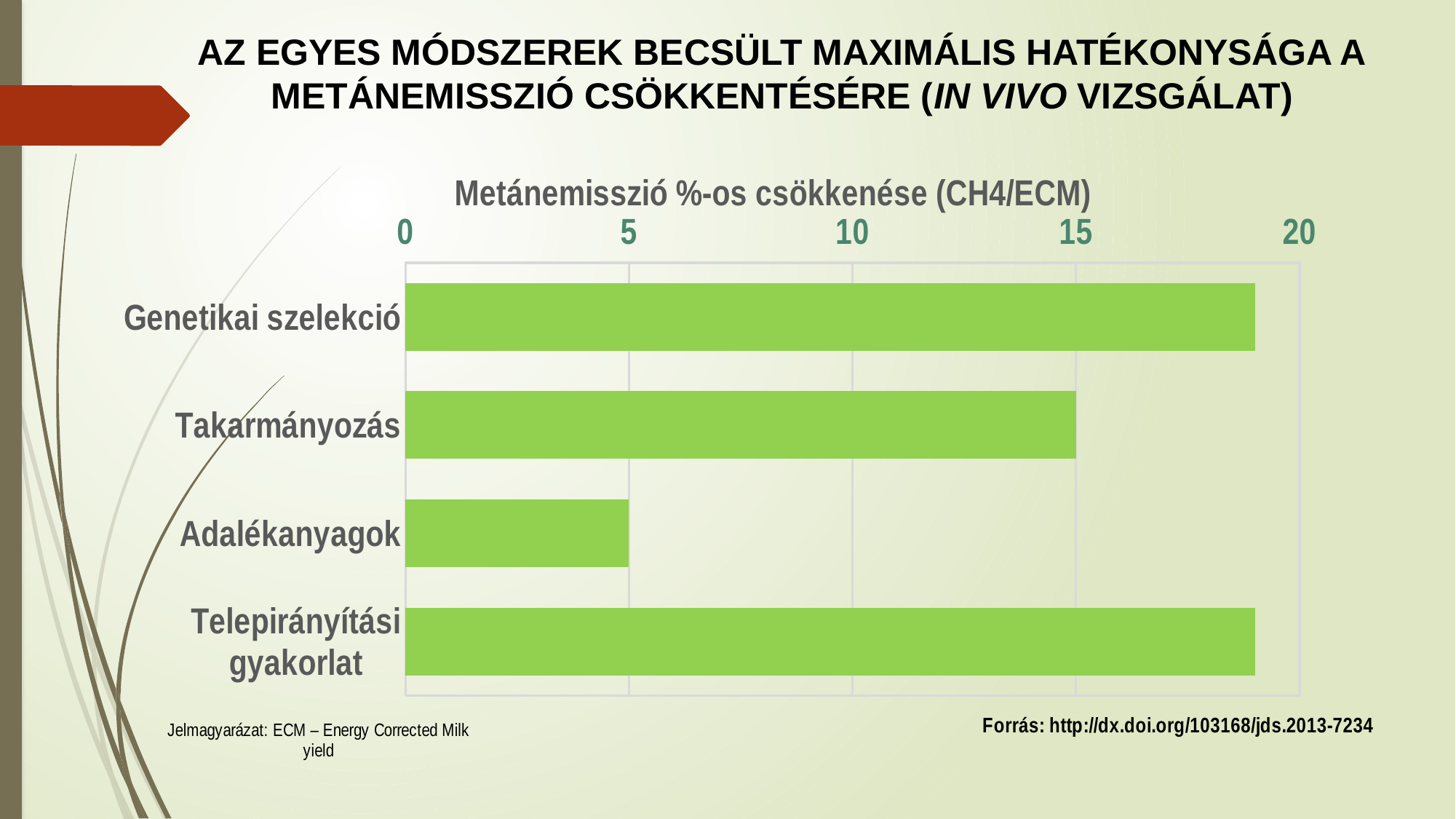
How many categories are plotted in the chart? 4 What is the title of the chart? Metánemisszió %-os csökkenése (CH4/ECM) What kind of chart is shown on the slide? bar chart Which is larger, the value for Adalékanyagok or the value for Telepirányítási gyakorlat? Telepirányítási gyakorlat Which category has the lowest value? Adalékanyagok Which is larger, the value for Genetikai szelekció or the value for Takarmányozás? Genetikai szelekció Is the value for Telepirányítási gyakorlat greater or less than 20? less What is the value for Adalékanyagok? 5 Is the value for Genetikai szelekció greater or less than 15? greater What is the highest value shown on the horizontal axis? 20 What is the difference between the values for Takarmányozás and Adalékanyagok? 10 What is the value for Takarmányozás? 15